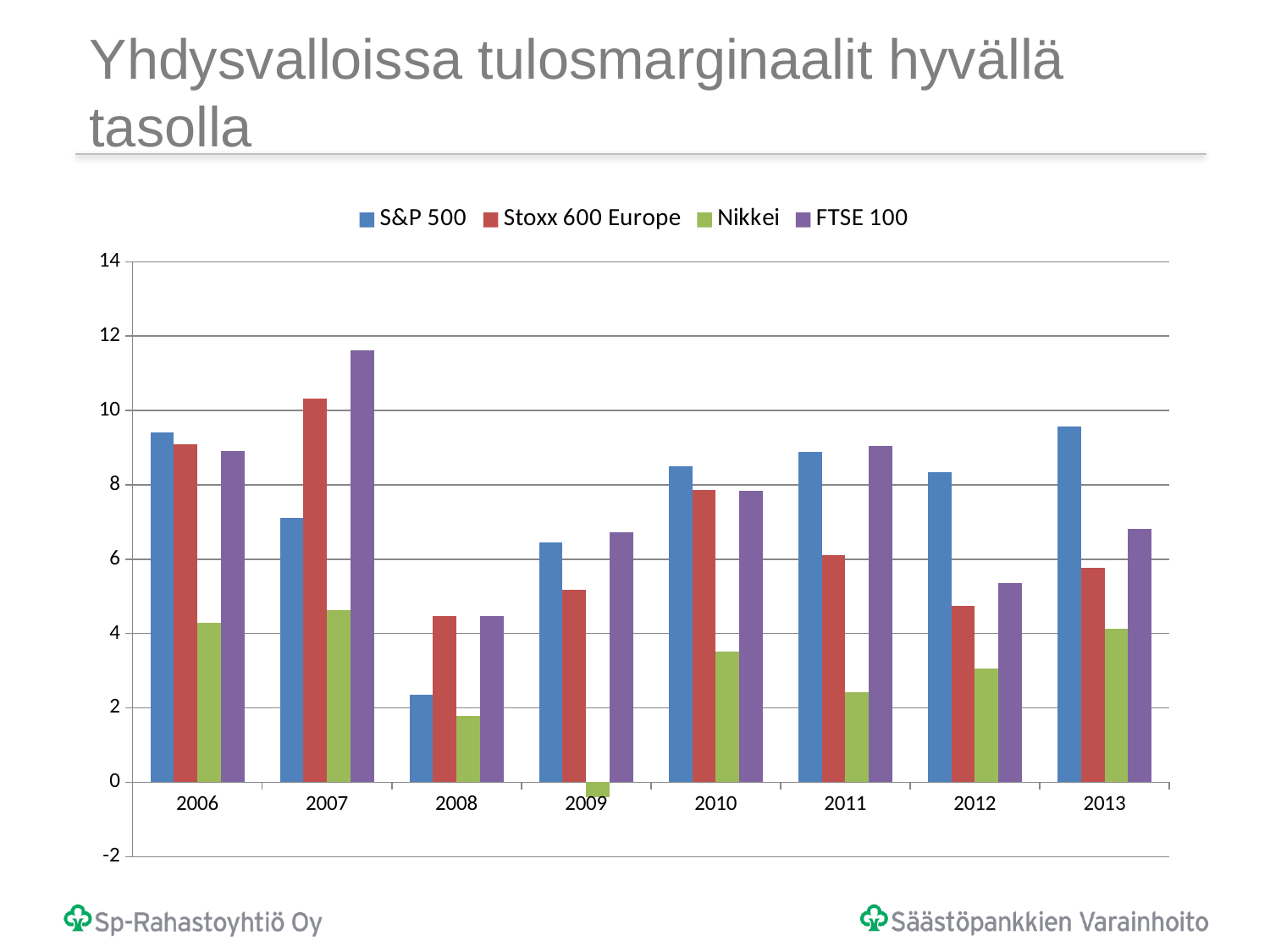
In 2013, which is larger: S&P 500 or FTSE 100? S&P 500 Which series has the highest bar in 2012? S&P 500 In which year is the FTSE 100 bar the highest? 2007 What colour represents Nikkei in the legend? green In 2007, which is larger: S&P 500 or Stoxx 600 Europe? Stoxx 600 Europe What kind of chart is shown on the slide? bar chart How many years are shown on the x axis? 8 Is the value for S&P 500 in 2008 greater or less than 4? less How many series does the legend list? 4 Is the value for Nikkei in 2009 greater or less than 0? less In which year is the S&P 500 bar the lowest? 2008 Is the value for FTSE 100 in 2007 greater or less than 10? greater